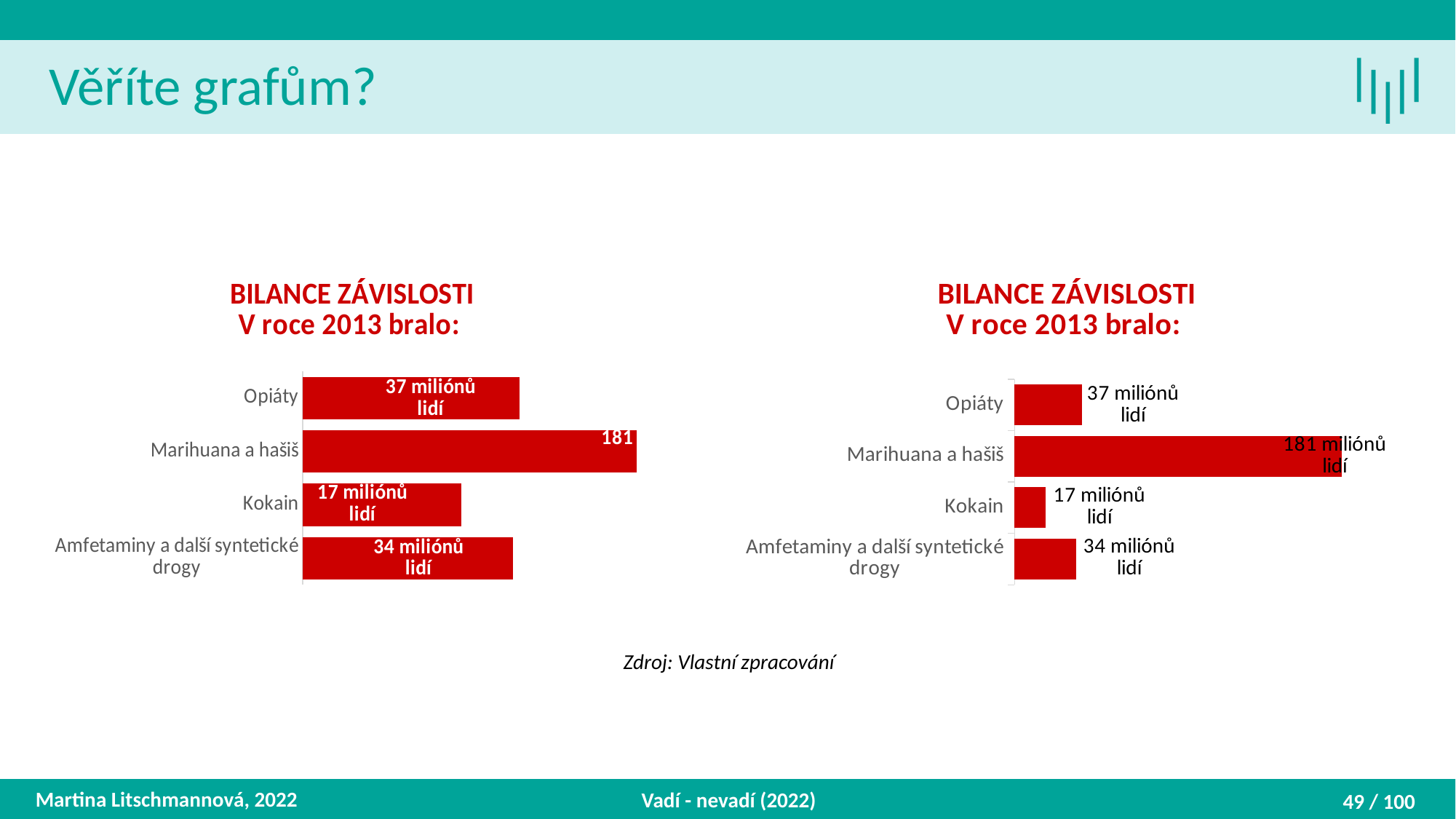
In the right chart, what value is shown for Marihuana a hašiš? 181 miliónů lidí In the left chart, which category has the lowest value? Kokain How many categories does the right chart show? 4 What type of chart is the left chart? bar chart In the right chart, what is the difference in millions of people between Opiáty and Kokain? 20 miliónů In the left chart, which is larger, the value for Opiáty or the value for Amfetaminy a další syntetické drogy? Opiáty In the left chart, what value is shown for Kokain? 17 miliónů lidí What is the title of the right chart? BILANCE ZÁVISLOSTI V roce 2013 bralo: What colour are the bars in the left chart? red In the right chart, which category has the highest value? Marihuana a hašiš In the right chart, what value is shown for Opiáty? 37 miliónů lidí In the left chart, what value is shown for Amfetaminy a další syntetické drogy? 34 miliónů lidí